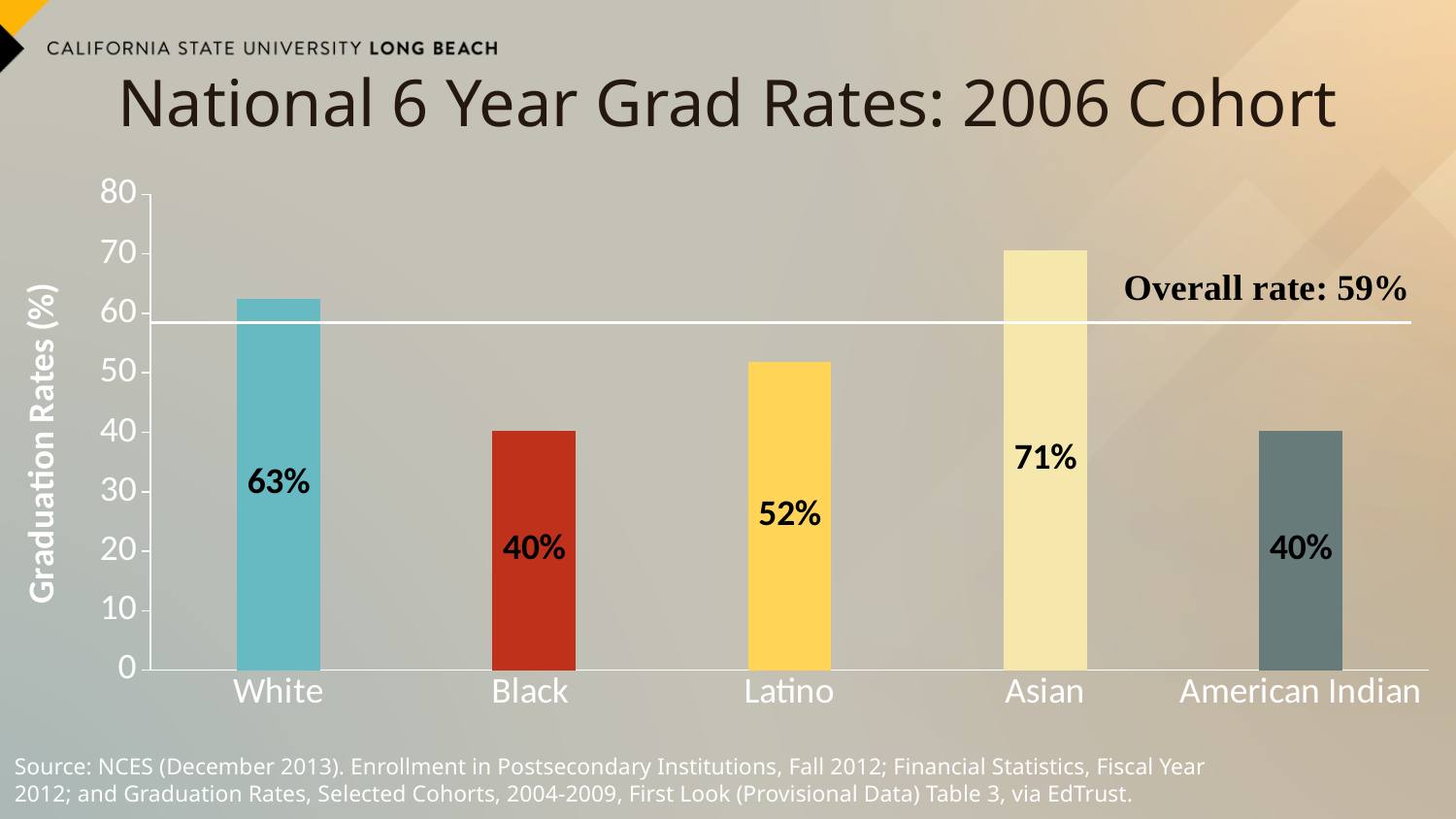
What is the graduation rate for White students? 63% Is the value for Latino students greater or less than 60? less What is the difference between the graduation rates for White and Latino students? 11% Which group has the highest graduation rate? Asian What is the graduation rate for Asian students? 71% What is the difference between the graduation rates for Asian and Black students? 31% What is the graduation rate for Latino students? 52% What kind of chart is shown on the slide? bar chart What is the overall rate shown by the horizontal line on the chart? 59% How many groups are shown on the x axis? 5 What is the title of the chart? National 6 Year Grad Rates: 2006 Cohort Which is larger, the graduation rate for White students or for Latino students? White